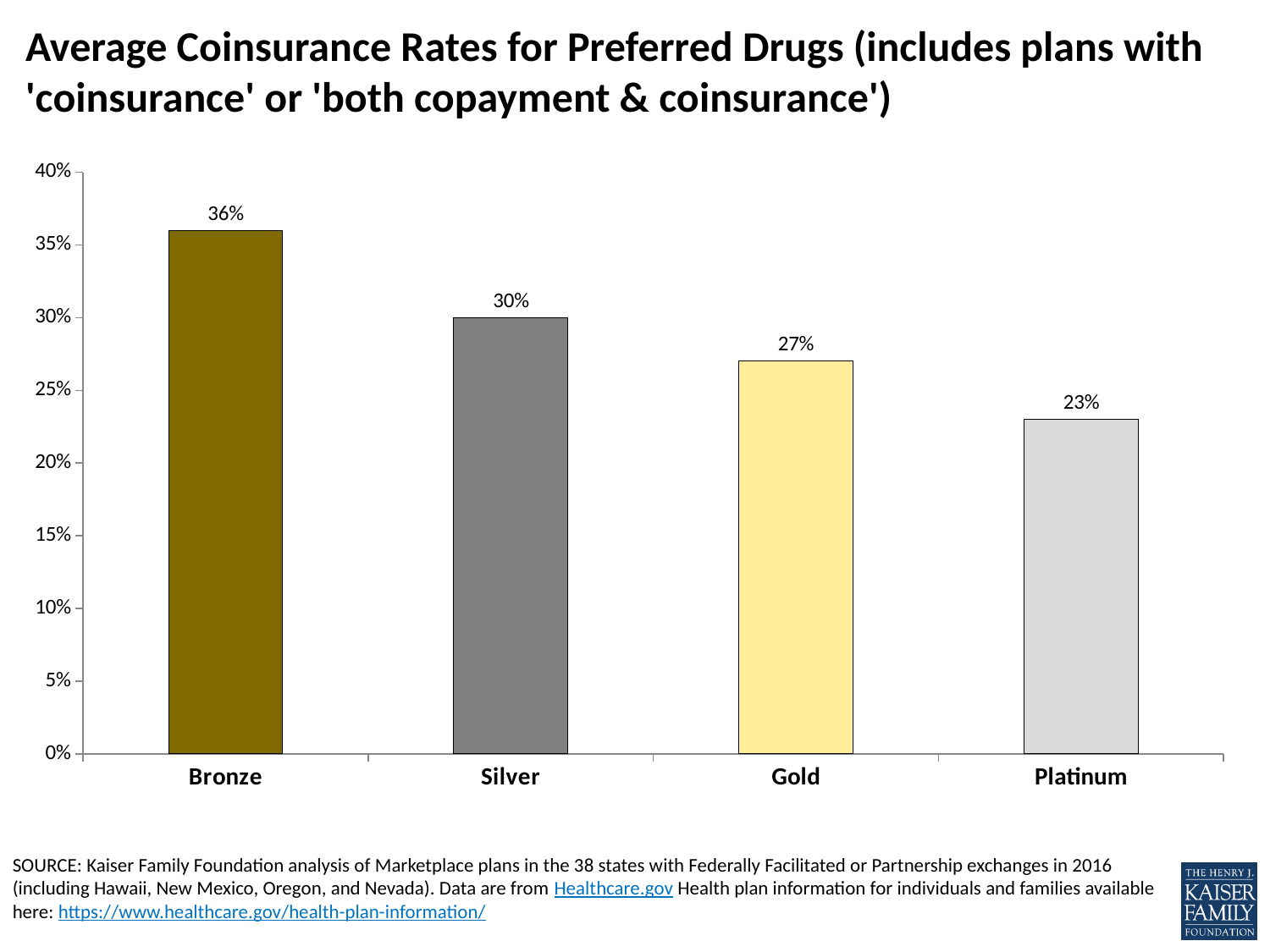
Which has a higher average coinsurance rate, Silver or Gold? Silver Which plan tier has the highest average coinsurance rate for preferred drugs? Bronze What is the average coinsurance rate for preferred drugs for Platinum plans? 23% What is the average coinsurance rate for preferred drugs for Gold plans? 27% What is the average coinsurance rate for preferred drugs for Silver plans? 30% Is the average coinsurance rate for Gold plans greater or less than 25%? greater What is the difference between the average coinsurance rates for Silver and Gold plans? 3% What is the difference between the average coinsurance rates for Bronze and Platinum plans? 13% How many plan tiers are shown in the chart? 4 What kind of chart is shown on the slide? Bar chart Which plan tier has the lowest average coinsurance rate for preferred drugs? Platinum What is the average coinsurance rate for preferred drugs for Bronze plans? 36%